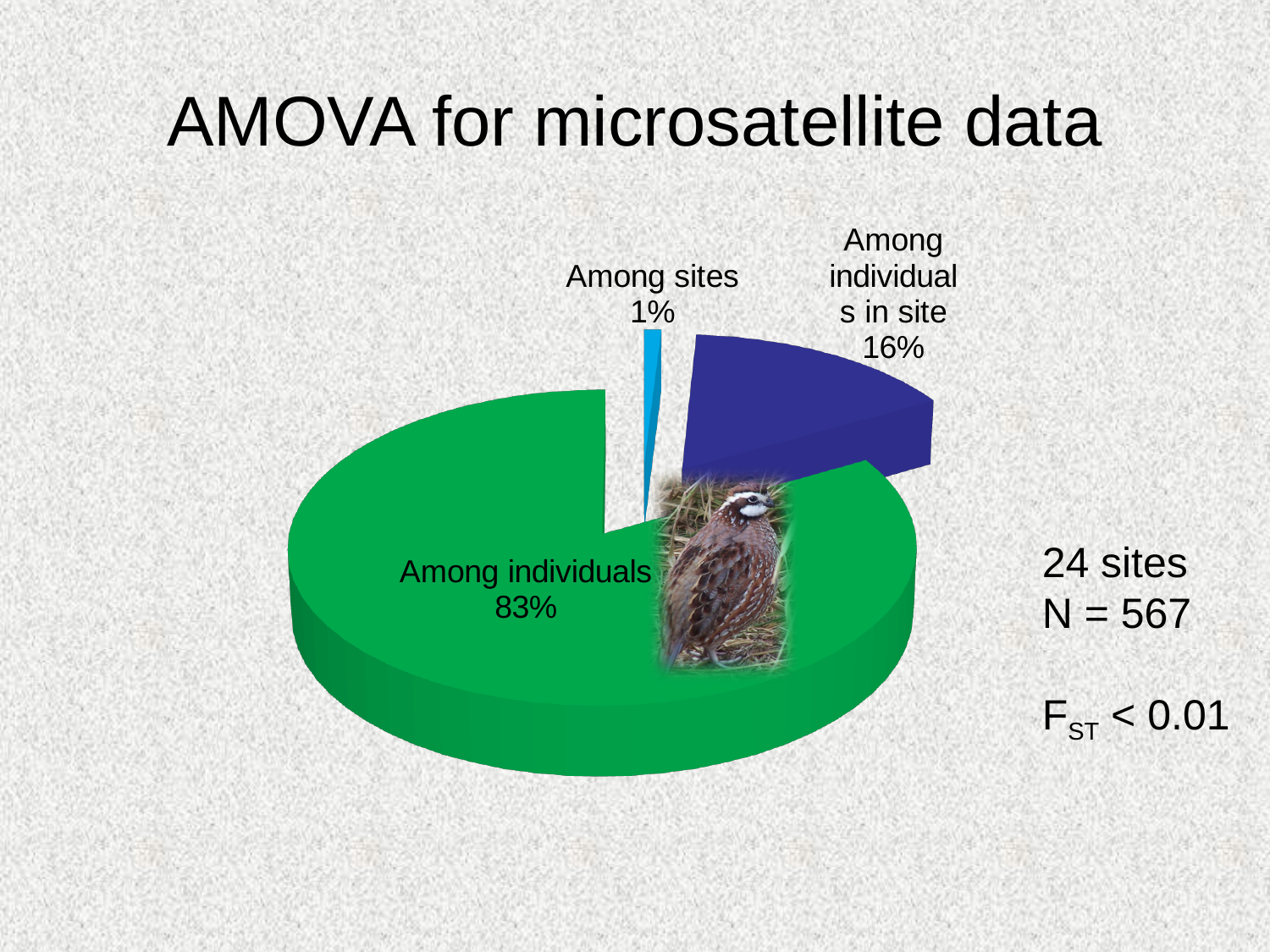
What is the difference in percentage points between the "Among individuals" slice and the "Among individuals in site" slice? 67 What kind of chart is shown on the slide? pie chart Which slice of the pie is the largest? Among individuals What share of the pie is labelled "Among sites"? 1% How many slices does the pie chart have? 3 What colour is the "Among individuals" slice of the pie? green Which slice of the pie is the smallest? Among sites What share of the pie is labelled "Among individuals in site"? 16% What is the title of the slide containing the pie chart? AMOVA for microsatellite data What share of the pie is labelled "Among individuals"? 83% Which is larger, the "Among individuals in site" slice or the "Among sites" slice? Among individuals in site